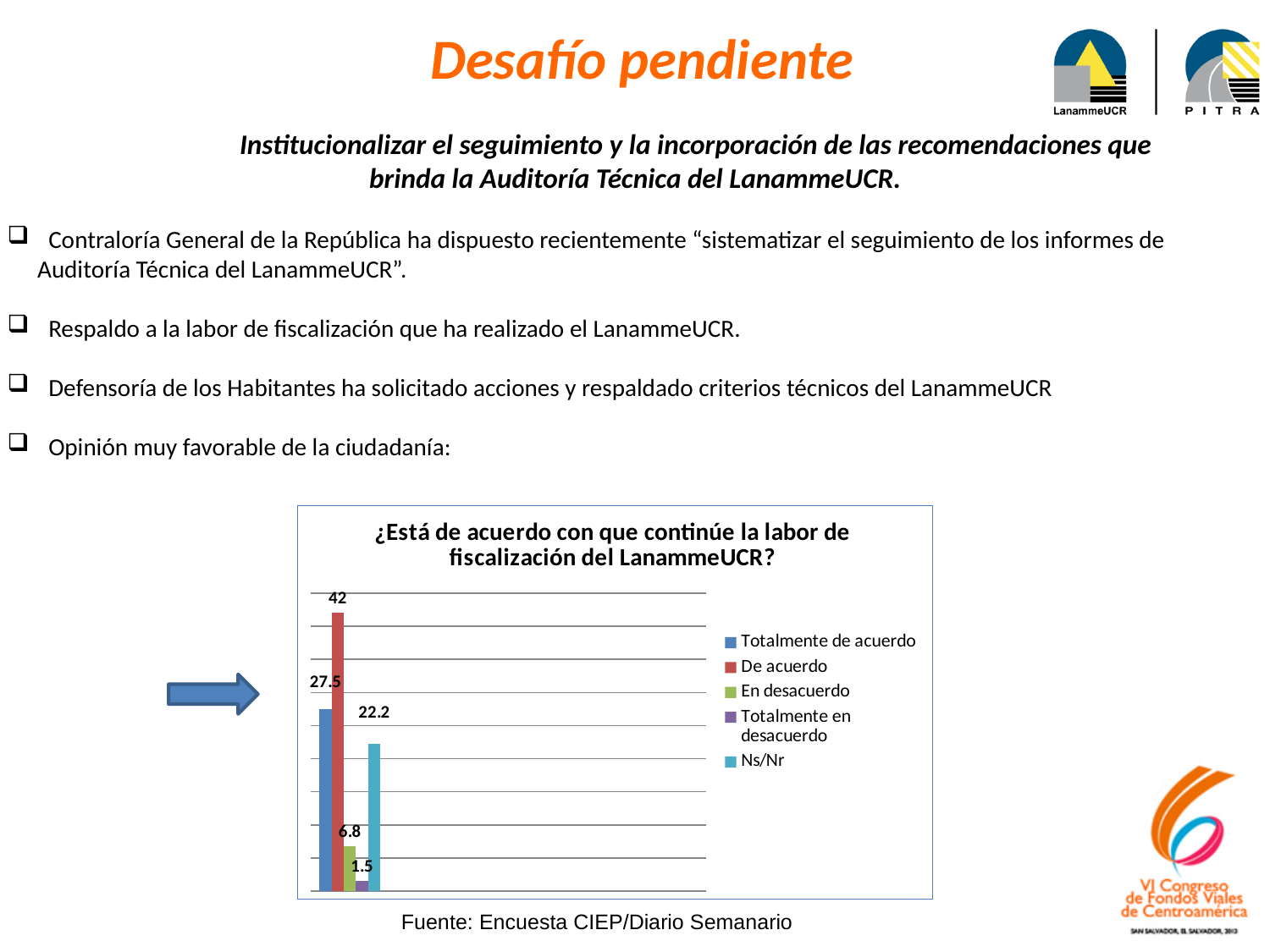
What is the value for "Totalmente en desacuerdo" in the chart? 1.5 Which series has the lowest value in the chart? Totalmente en desacuerdo What is the value for "De acuerdo" in the chart? 42 What is the value for "Ns/Nr" in the chart? 22.2 How many series does the chart legend list? 5 What type of chart is shown on the slide? bar chart What is the title of the chart? ¿Está de acuerdo con que continúe la labor de fiscalización del LanammeUCR? What is the value for "En desacuerdo" in the chart? 6.8 What is the difference between the values for "De acuerdo" and "Totalmente de acuerdo"? 14.5 What is the value for "Totalmente de acuerdo" in the chart? 27.5 Which series has the highest value in the chart? De acuerdo Which is larger, the value for "Ns/Nr" or the value for "En desacuerdo"? Ns/Nr